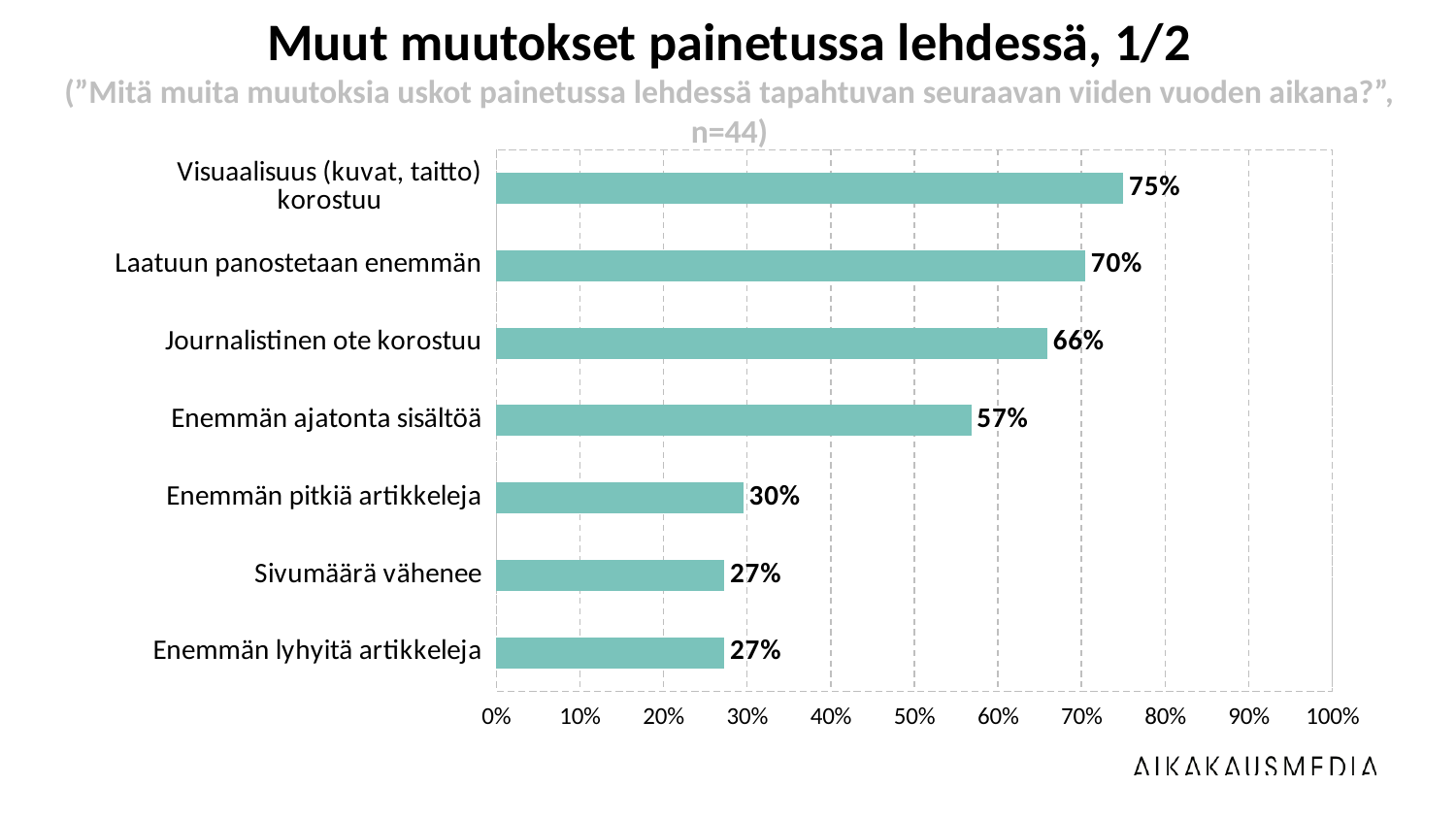
Is the value for "Enemmän ajatonta sisältöä" greater or less than 50%? greater Which category has the highest value? Visuaalisuus (kuvat, taitto) korostuu What is the difference between "Laatuun panostetaan enemmän" and "Journalistinen ote korostuu"? 4% What is the value for "Visuaalisuus (kuvat, taitto) korostuu"? 75% What is the sample size (n) stated in the chart subtitle? 44 What is the value for "Enemmän ajatonta sisältöä"? 57% What is the title of the chart? Muut muutokset painetussa lehdessä, 1/2 What kind of chart is shown on the slide? Bar chart How many categories are shown in the chart? 7 Which is larger, "Enemmän pitkiä artikkeleja" or "Enemmän lyhyitä artikkeleja"? Enemmän pitkiä artikkeleja What is the difference between "Visuaalisuus (kuvat, taitto) korostuu" and "Enemmän lyhyitä artikkeleja"? 48% What is the value for "Sivumäärä vähenee"? 27%